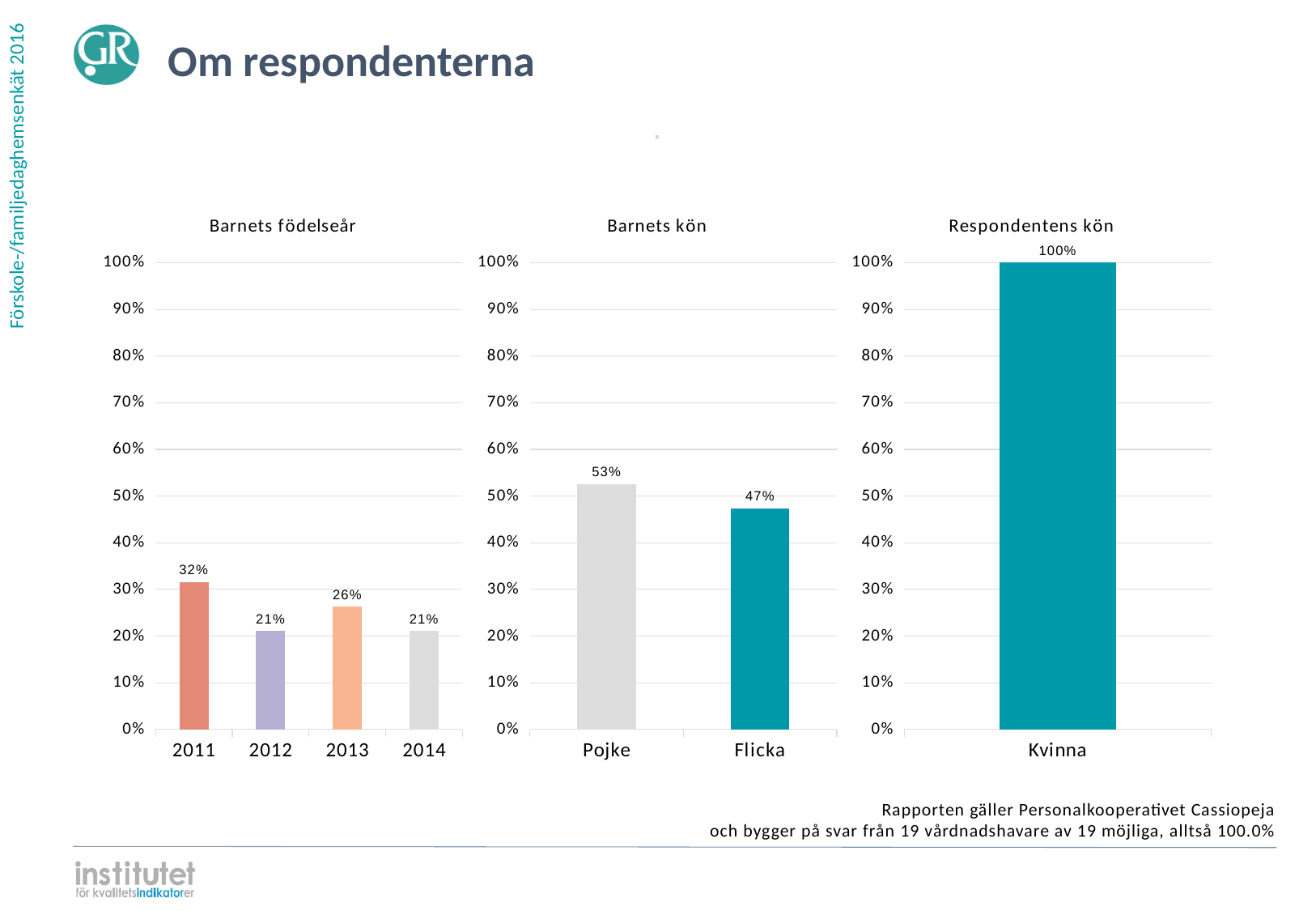
In the 'Respondentens kön' chart, what is the value for Kvinna? 100% In the 'Barnets kön' chart, what is the value for Flicka? 47% What kind of chart is the 'Respondentens kön' chart? Bar chart In the 'Barnets födelseår' chart, which birth year has the highest value? 2011 In the 'Barnets födelseår' chart, how many birth years are shown on the x axis? 4 In the 'Barnets födelseår' chart, what is the difference between the values for 2011 and 2013? 6% In the 'Barnets kön' chart, what is the value for Pojke? 53% In the 'Barnets födelseår' chart, is the value for 2012 greater or less than 30%? less In the 'Barnets födelseår' chart, what is the value for 2011? 32% In the 'Barnets kön' chart, which is larger, Pojke or Flicka? Pojke In the 'Barnets födelseår' chart, what is the value for 2013? 26% In the 'Barnets kön' chart, what is the difference between Pojke and Flicka? 6%